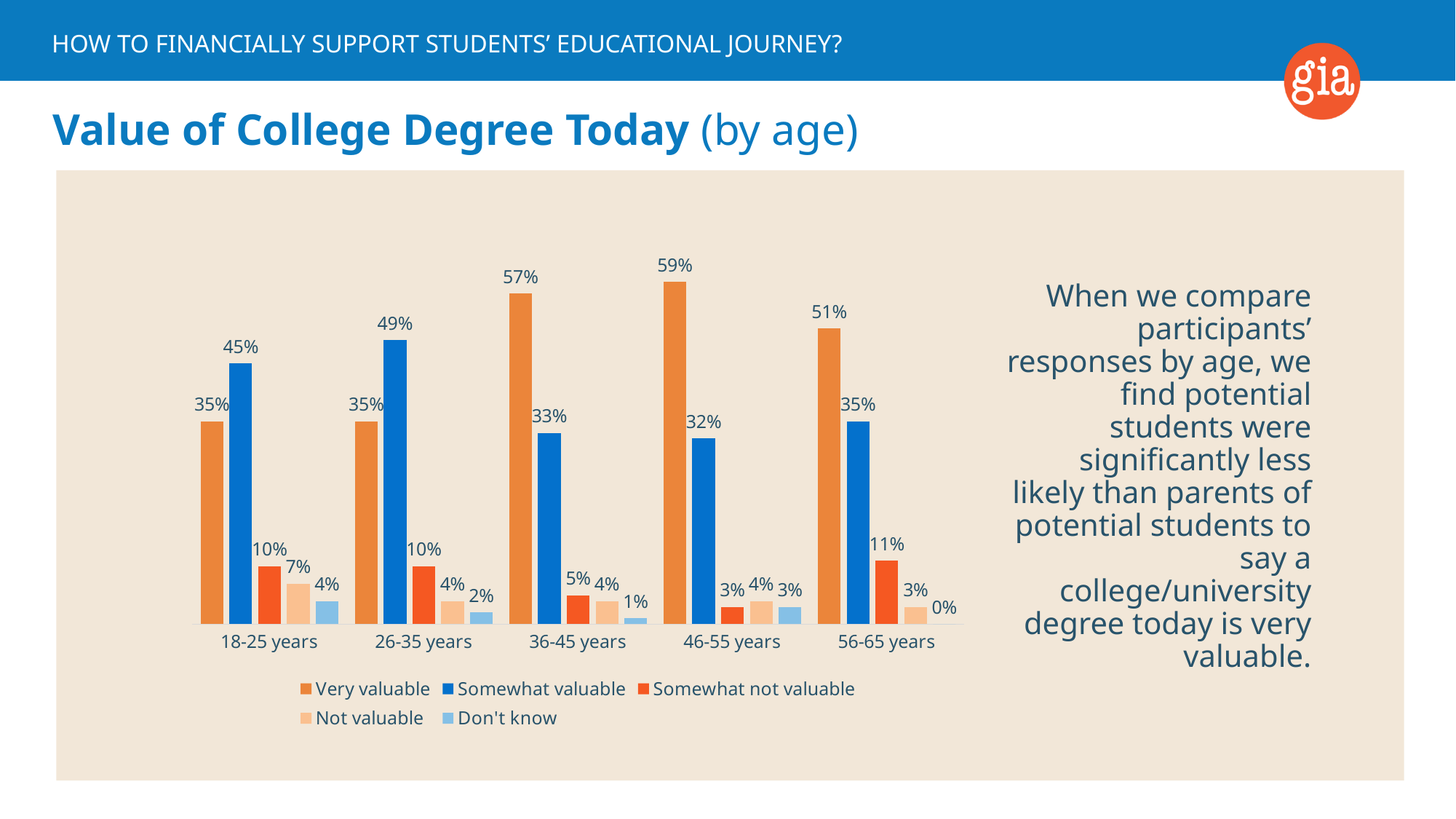
Which age group has the highest 'Very valuable' value? 46-55 years What percentage of 18-25 year olds said a college degree is somewhat valuable? 45% What is the 'Somewhat not valuable' value for the 56-65 years group? 11% What is the title of the chart? Value of College Degree Today (by age) What is the 'Don't know' value for the 56-65 years group? 0% What is the difference between the 'Very valuable' values for 46-55 years and 18-25 years? 24% What kind of chart is shown on the slide? Bar chart How many series does the legend list? 5 How many age groups are shown on the x axis? 5 What percentage of 36-45 year olds said a college degree is very valuable? 57% Which age group has the lowest 'Somewhat valuable' value? 46-55 years Which is larger for the 26-35 years group: 'Very valuable' or 'Somewhat valuable'? Somewhat valuable